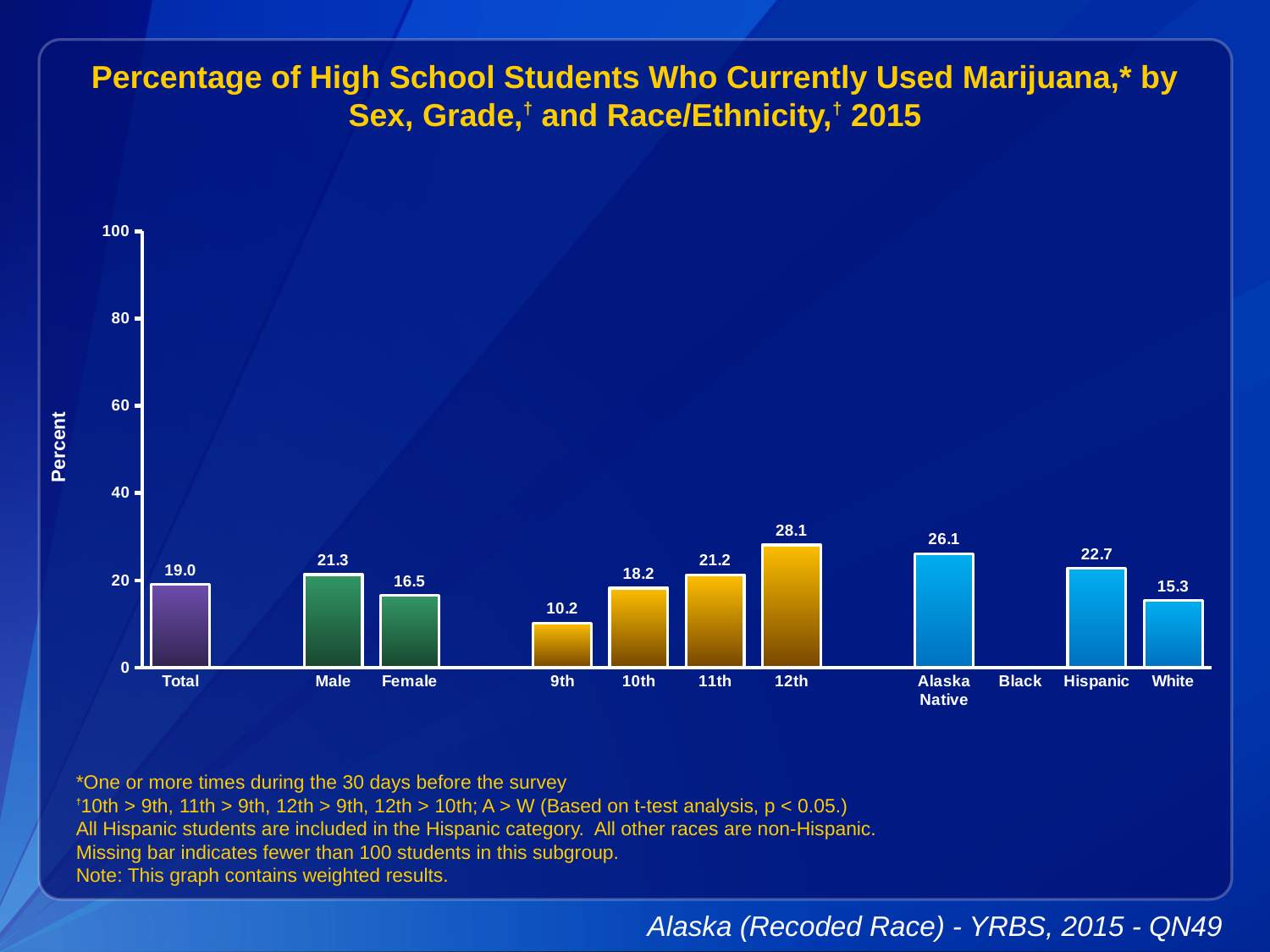
What is the value for Total? 19.0 Which category has the lowest value among the bars shown? 9th Which is larger, the value for Hispanic or the value for White? Hispanic What kind of chart is shown? bar chart Is the value for 11th grade greater or less than 20? greater What is the value for 12th grade students? 28.1 Which category has the highest value? 12th Do the values rise or fall from 9th grade to 12th grade? rise What is the value for Alaska Native students? 26.1 Which race/ethnicity category has no bar shown? Black What is the difference between the Male and Female values? 4.8 How many bars are plotted on the chart? 11